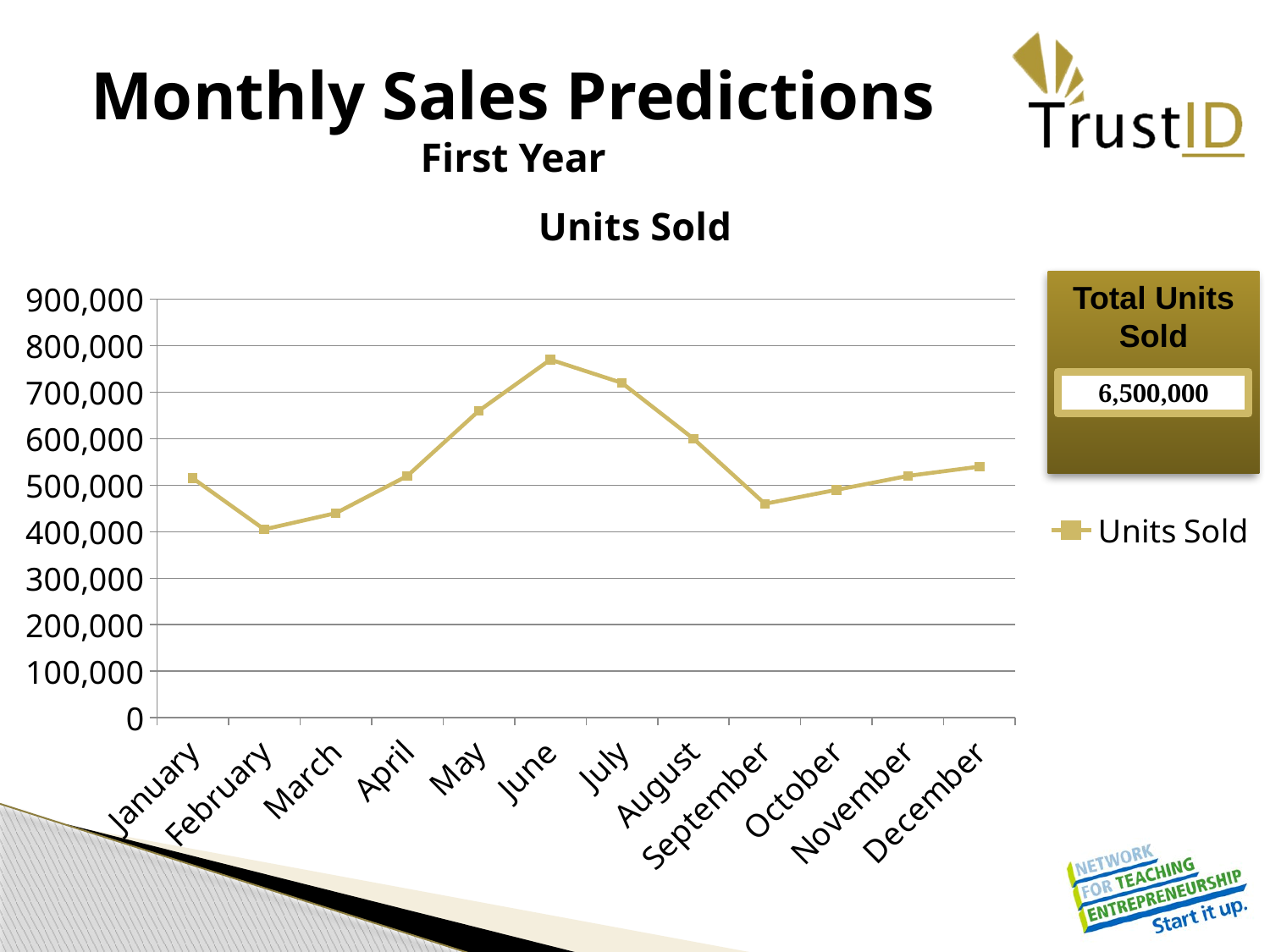
Which month has the highest value for Units Sold? June What is the Total Units Sold figure shown in the box next to the chart? 6,500,000 Do the Units Sold values rise or fall from February to June? rise Is the value for Units Sold in September greater or less than 500,000? less How many months are plotted on the x axis of the Units Sold chart? 12 What kind of chart is shown on the slide? line chart Which month has the lowest value for Units Sold? February Is the value for Units Sold in August greater or less than 500,000? greater Is the value for Units Sold in February greater or less than 500,000? less Which month has the larger value for Units Sold, May or September? May How many series does the legend of the Units Sold chart list? 1